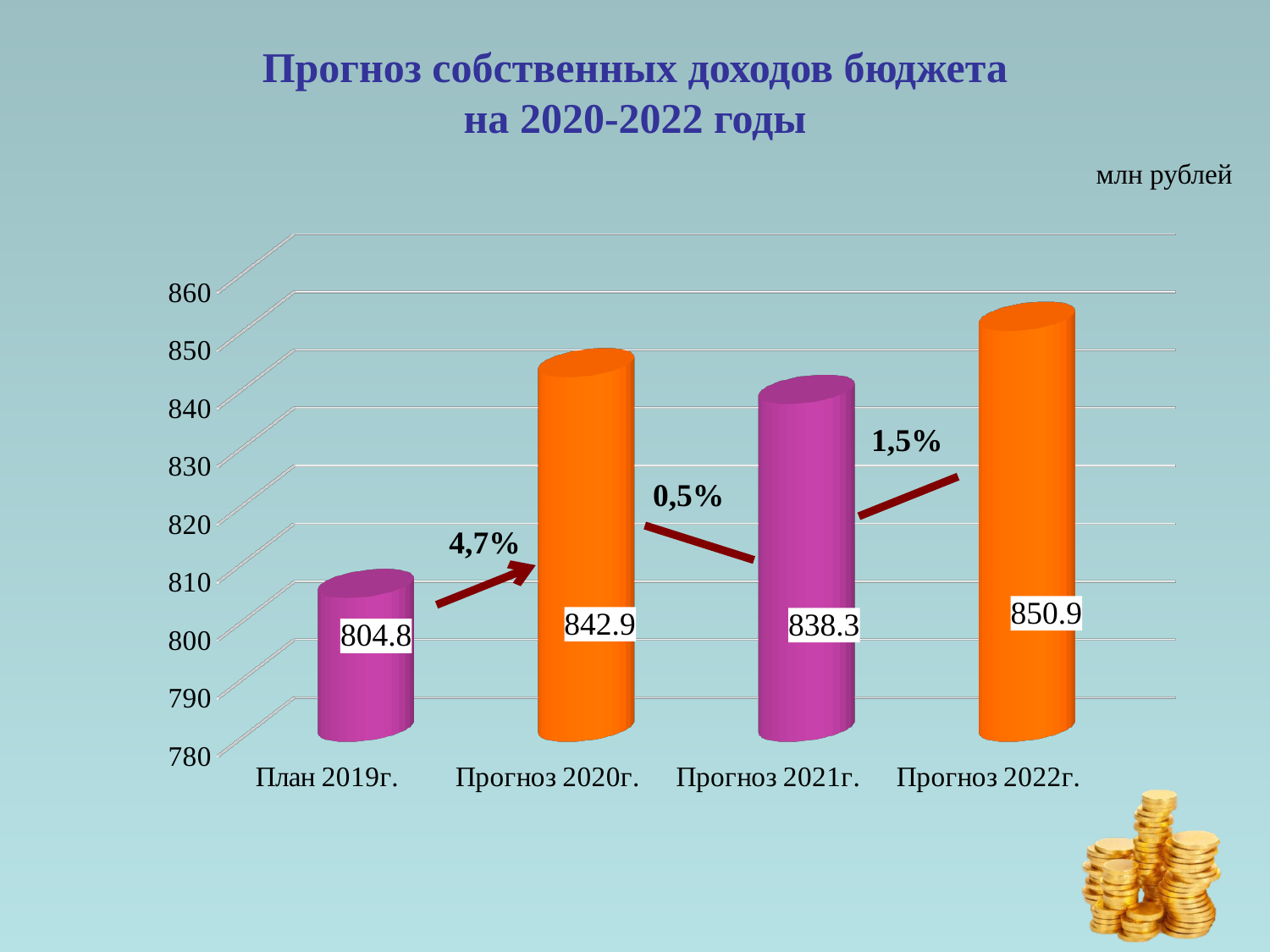
Which is larger, the value for Прогноз 2020г. or Прогноз 2021г.? Прогноз 2020г. How many categories are shown on the x axis? 4 What is the difference between the values for Прогноз 2022г. and План 2019г.? 46.1 What unit is stated for the values on the chart? млн рублей What is the difference between the values for Прогноз 2020г. and Прогноз 2021г.? 4.6 What is the value for Прогноз 2020г.? 842.9 Which category has the highest value? Прогноз 2022г. What is the value for Прогноз 2021г.? 838.3 What is the value for Прогноз 2022г.? 850.9 Which category has the lowest value? План 2019г. What kind of chart is this? bar chart What is the value for План 2019г.? 804.8